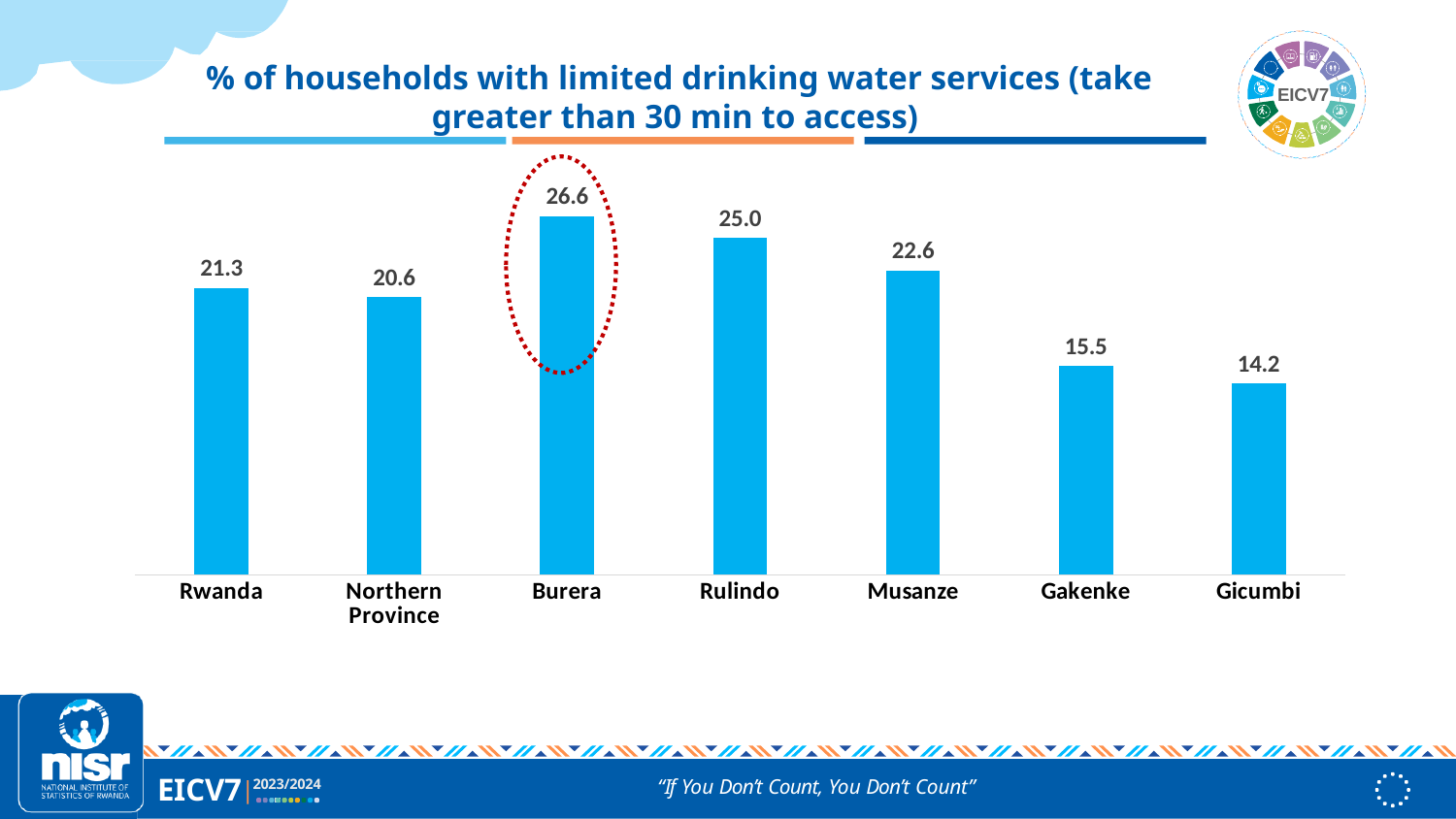
Which category's bar is highlighted with a red dotted circle? Burera Which category has the highest value? Burera What is the value for Gicumbi? 14.2 What is the value for Northern Province? 20.6 What is the difference between the values for Rwanda and Northern Province? 0.7 How many categories are shown on the x axis? 7 What kind of chart is shown on the slide? Bar chart Which category has the lowest value? Gicumbi What is the difference between the values for Burera and Gicumbi? 12.4 Which is larger, the value for Rulindo or the value for Musanze? Rulindo What is the value for Burera? 26.6 Which is larger, the value for Gakenke or the value for Gicumbi? Gakenke